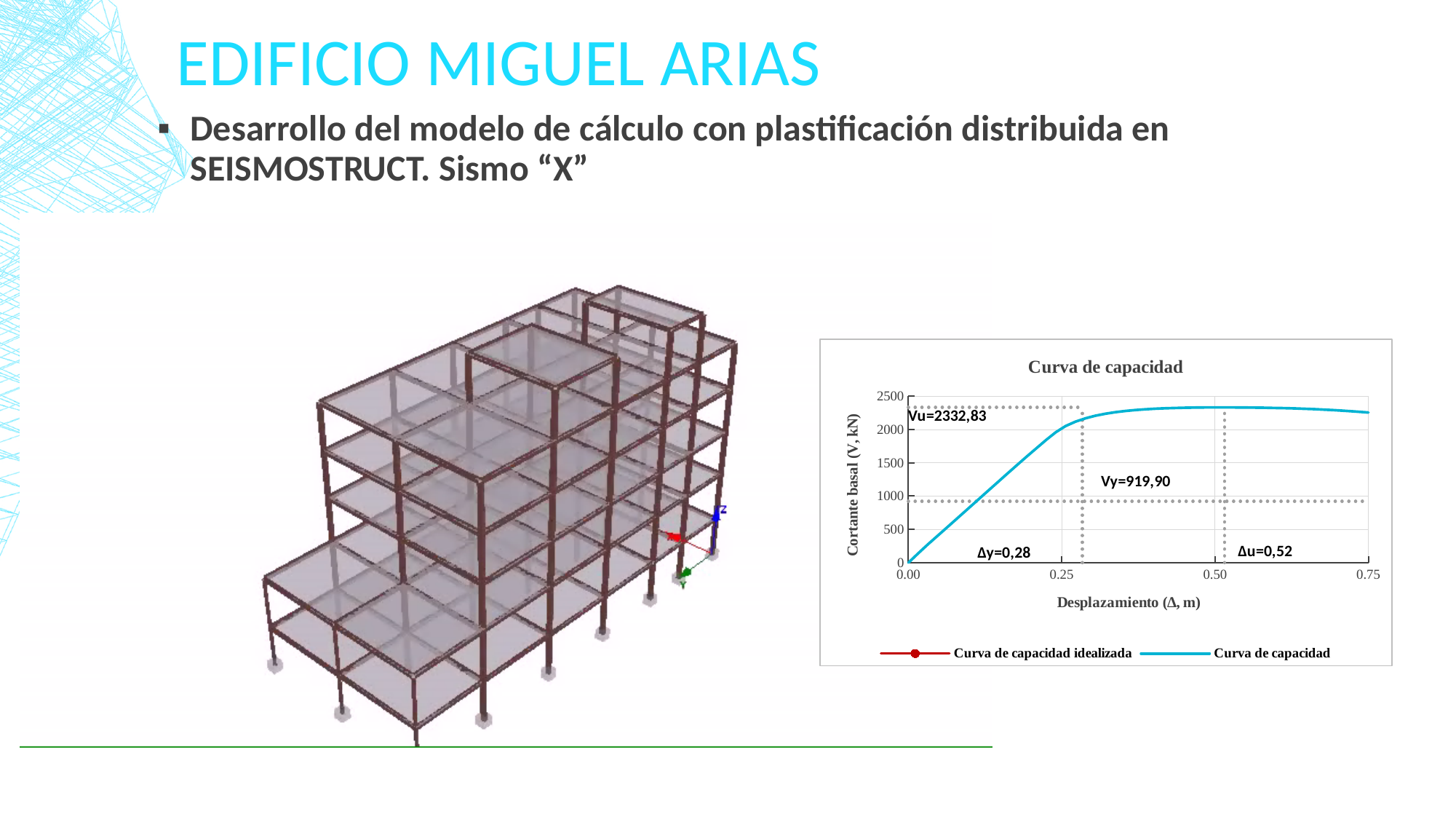
What is the difference between Δu and Δy as annotated on the chart? 0,24 What kind of chart is shown on the slide? Line chart What value of Vu is annotated on the chart? 2332,83 How many series does the chart legend list? 2 What value of Δy is annotated on the chart? 0,28 What value of Vy is annotated on the chart? 919,90 Is the base shear (Cortante basal) at a displacement of 0.25 m greater or less than 1500? greater What is the title of the chart on the slide? Curva de capacidad What is the difference between Vu and Vy as annotated on the chart? 1412,93 What value of Δu is annotated on the chart? 0,52 Which is larger, Vu or Vy? Vu What is the label of the x axis of the chart? Desplazamiento (Δ, m)